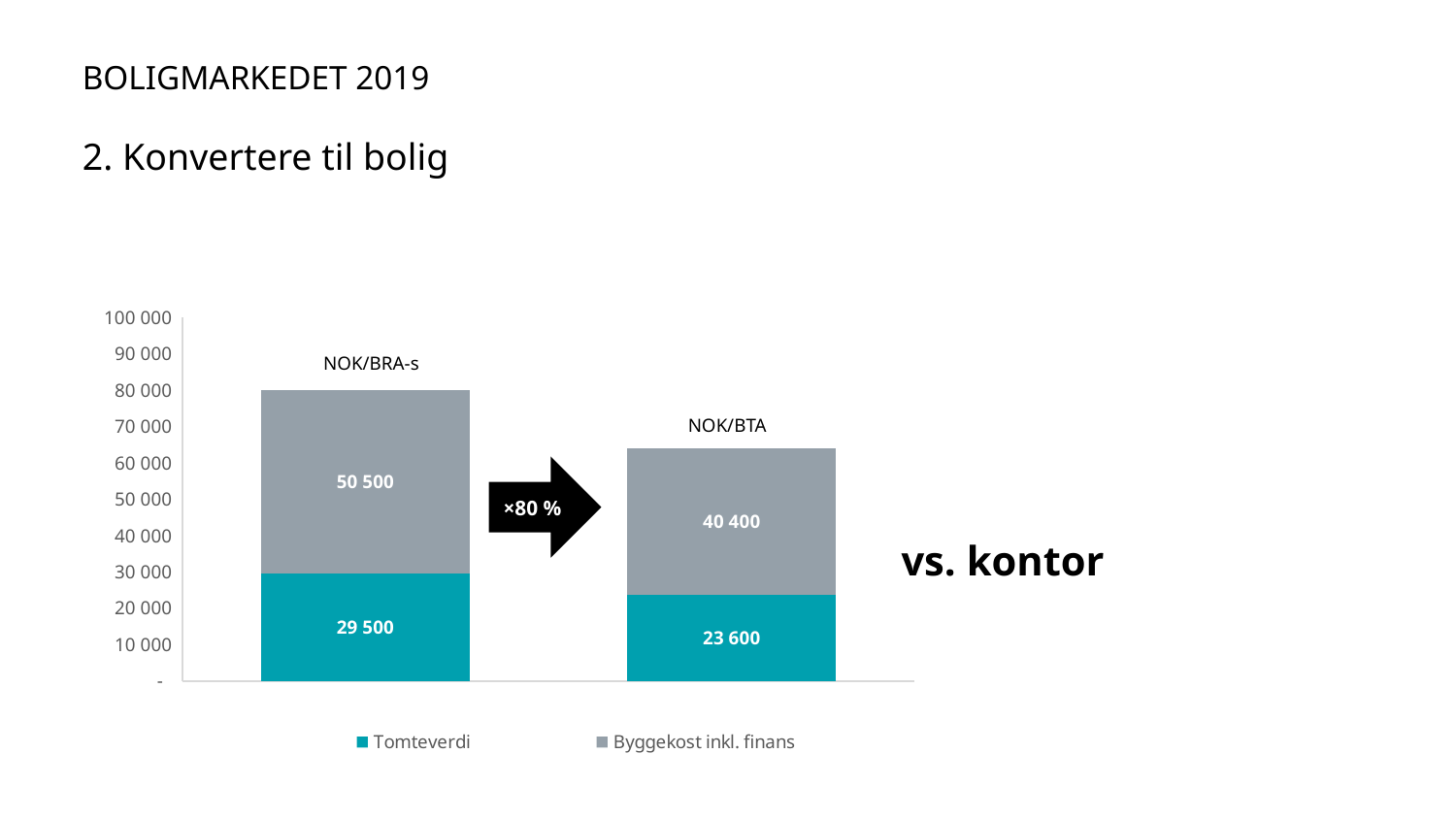
What percentage is shown in the arrow between the two bars? ×80 % What is the Tomteverdi value for the NOK/BRA-s bar? 29 500 What is the difference between the Byggekost inkl. finans values for NOK/BRA-s and NOK/BTA? 10 100 What is the difference between the Tomteverdi values for NOK/BRA-s and NOK/BTA? 5 900 How many series does the legend list? 2 Which bar has the higher Byggekost inkl. finans value, NOK/BRA-s or NOK/BTA? NOK/BRA-s What is the total of the NOK/BTA stacked bar? 64 000 What is the Tomteverdi value for the NOK/BTA bar? 23 600 What is the Byggekost inkl. finans value for the NOK/BTA bar? 40 400 What is the Byggekost inkl. finans value for the NOK/BRA-s bar? 50 500 What kind of chart is shown on the slide? Stacked bar chart What is the total of the NOK/BRA-s stacked bar? 80 000